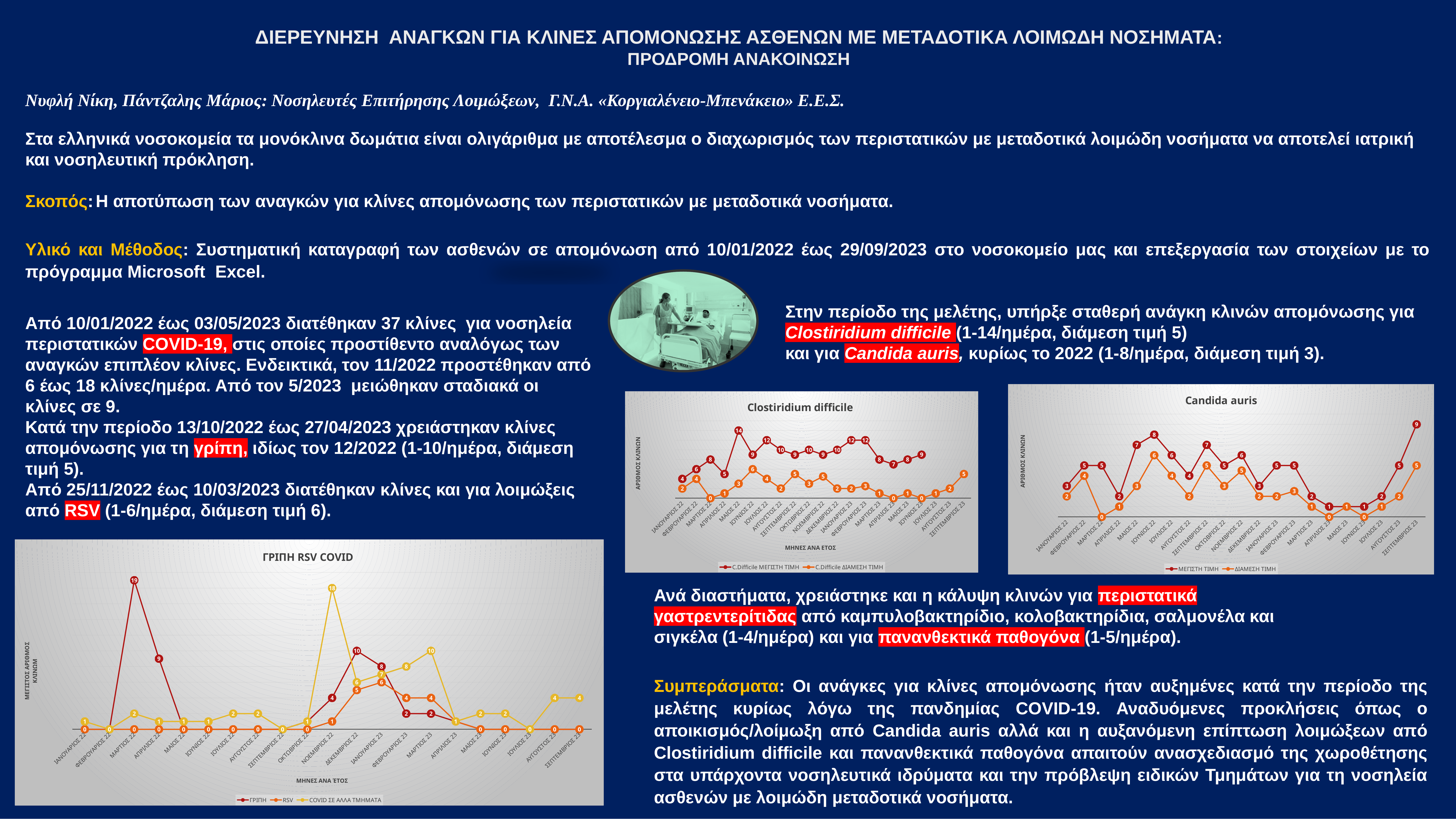
In the chart titled 'ΓΡΙΠΗ RSV COVID', how many series does the legend list? 3 In the chart titled 'ΓΡΙΠΗ RSV COVID', what is the difference between the ΓΡΙΠΗ value in ΔΕΚΕΜΒΡΙΟΣ 22 (10) and the RSV value in ΔΕΚΕΜΒΡΙΟΣ 22 (5)? 5 In the chart titled 'ΓΡΙΠΗ RSV COVID', what is the highest value of the ΓΡΙΠΗ series? 19 In the chart titled 'Clostiridium difficile', what is the highest value of the C.Difficile ΜΕΓΙΣΤΗ ΤΙΜΗ series? 14 In the chart titled 'Candida auris', which is larger in ΙΟΥΝΙΟΣ 22: the ΜΕΓΙΣΤΗ ΤΙΜΗ value or the ΔΙΑΜΕΣΗ ΤΙΜΗ value? ΜΕΓΙΣΤΗ ΤΙΜΗ In the chart titled 'ΓΡΙΠΗ RSV COVID', what type of chart is shown? Line chart In the chart titled 'Clostiridium difficile', in which month does the C.Difficile ΜΕΓΙΣΤΗ ΤΙΜΗ series reach its highest value? ΜΑΙΟΣ 22 In the chart titled 'Candida auris', what is the y-axis label? ΑΡΙΘΜΟΣ ΚΛΙΝΩΝ In the chart titled 'ΓΡΙΠΗ RSV COVID', what is the value of the COVID ΣΕ ΑΛΛΑ ΤΜΗΜΑΤΑ series in ΝΟΕΜΒΡΙΟΣ 22? 18 In the chart titled 'ΓΡΙΠΗ RSV COVID', what is the value of the RSV series in ΙΑΝΟΥΑΡΙΟΣ 23? 6 In the chart titled 'Clostiridium difficile', how many series does the legend list? 2 In the chart titled 'Candida auris', what is the value of the ΜΕΓΙΣΤΗ ΤΙΜΗ series in ΣΕΠΤΕΜΒΡΙΟΣ 23? 9